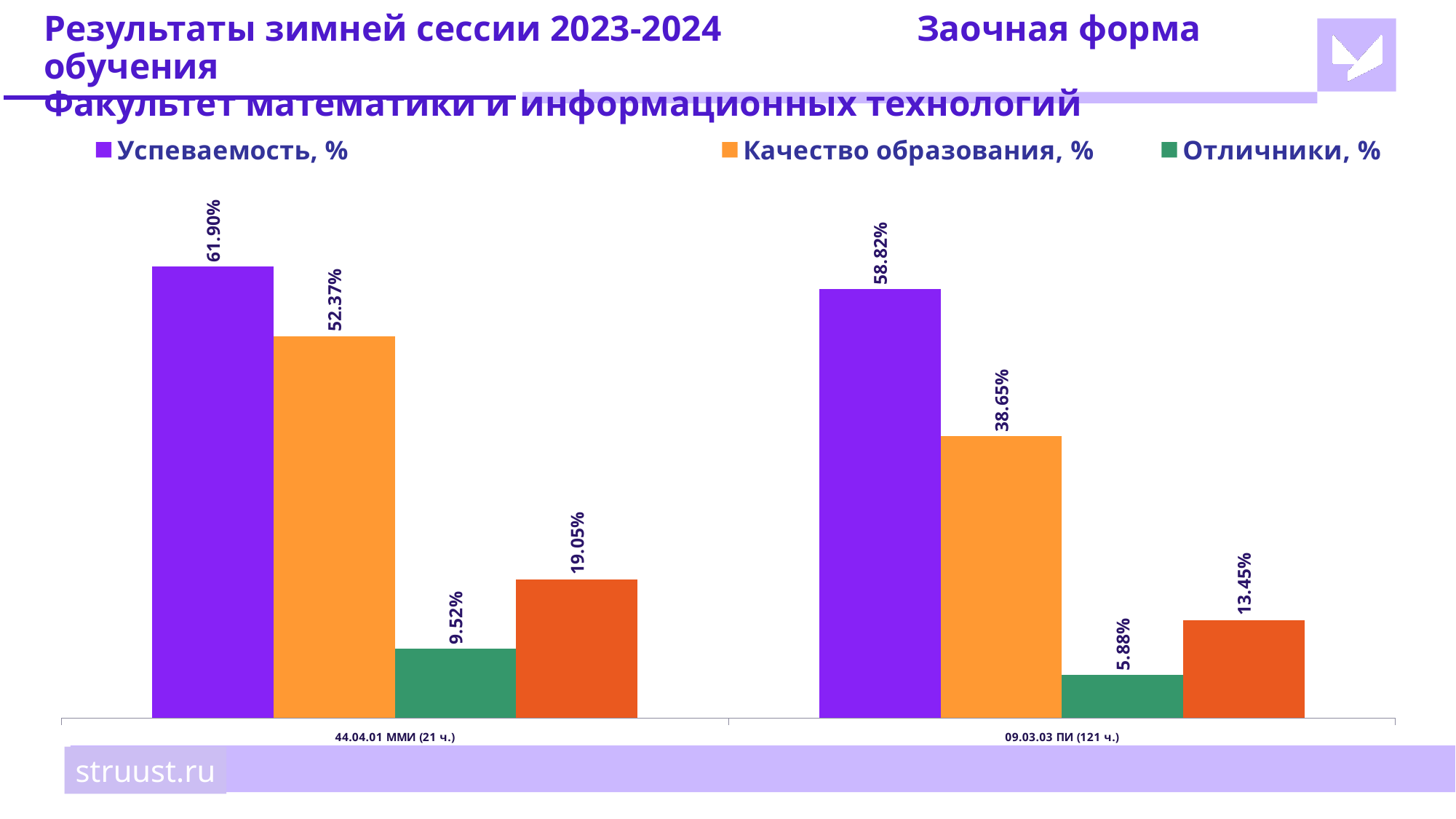
Is Отличники, % higher for 44.04.01 ММИ (21 ч.) or for 09.03.03 ПИ (121 ч.)? 44.04.01 ММИ (21 ч.) What is the difference between Качество образования, % for 44.04.01 ММИ (21 ч.) and for 09.03.03 ПИ (121 ч.)? 13.72% What is the value of Успеваемость, % for 09.03.03 ПИ (121 ч.)? 58.82% What type of chart is shown on the slide? Bar chart What is the value of Отличники, % for 44.04.01 ММИ (21 ч.)? 9.52% Which category has the higher Качество образования, %? 44.04.01 ММИ (21 ч.) Which category has the lower Отличники, %? 09.03.03 ПИ (121 ч.) What is the value of Качество образования, % for 09.03.03 ПИ (121 ч.)? 38.65% What is the difference between Успеваемость, % for 44.04.01 ММИ (21 ч.) and for 09.03.03 ПИ (121 ч.)? 3.08% How many categories are shown on the x axis of the chart? 2 How many series does the chart legend list? 3 What is the value of Успеваемость, % for 44.04.01 ММИ (21 ч.)? 61.90%